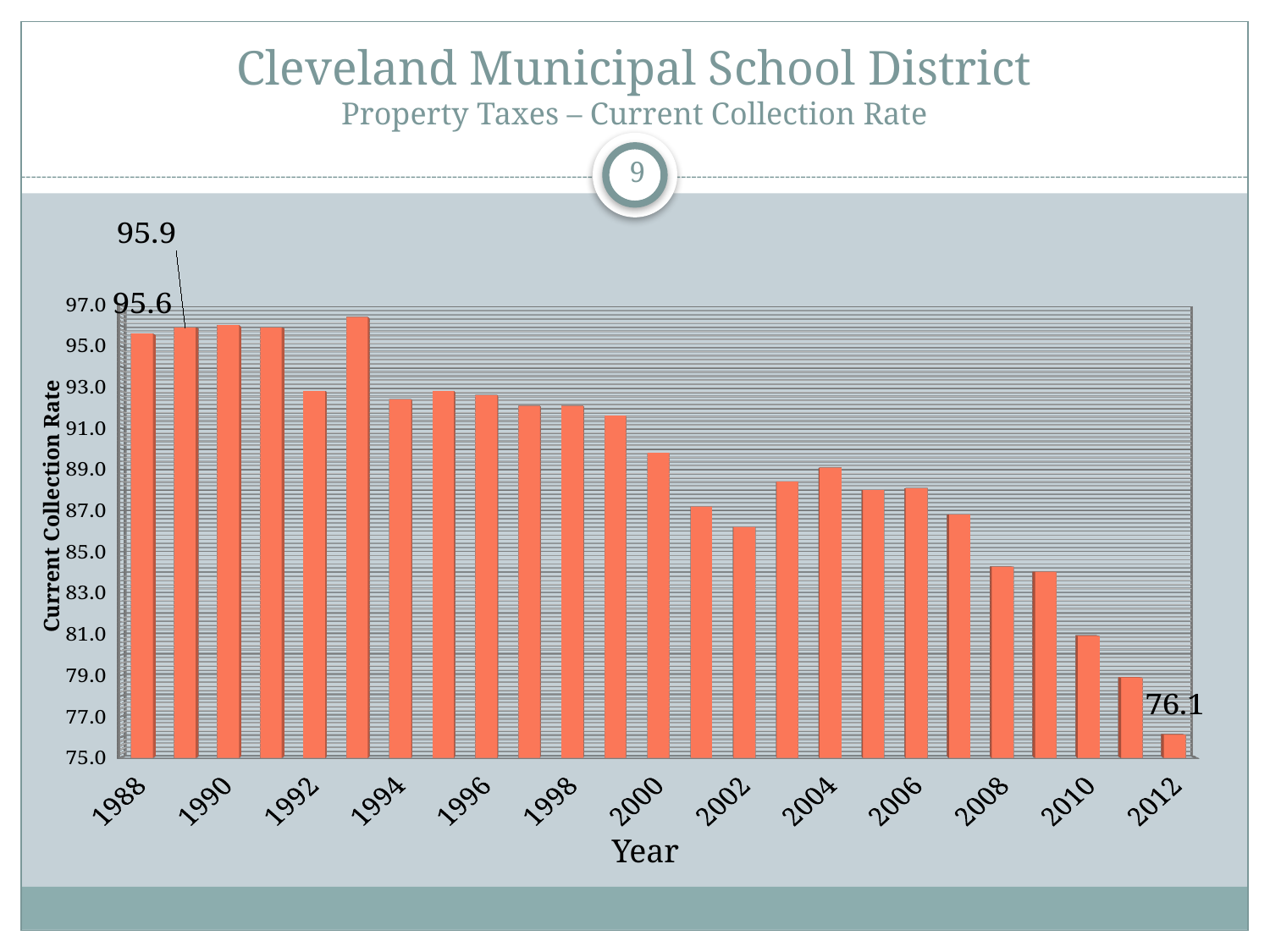
Do the collection rates generally rise or fall from 1988 to 2012? Fall What is the current collection rate for 2012? 76.1 What is the difference between the collection rates for 1988 and 2012? 19.5 What kind of chart is shown on the slide? Bar chart Is the value for 2000 greater or less than 89.0? greater Which year has the lowest current collection rate? 2012 What is the difference between the collection rates for 1989 and 1988? 0.3 How many years are plotted in the chart? 25 What is the current collection rate for 1989? 95.9 Is the value for 2002 greater or less than 87.0? less What is the current collection rate for 1988? 95.6 Which year has a higher collection rate, 1988 or 2012? 1988